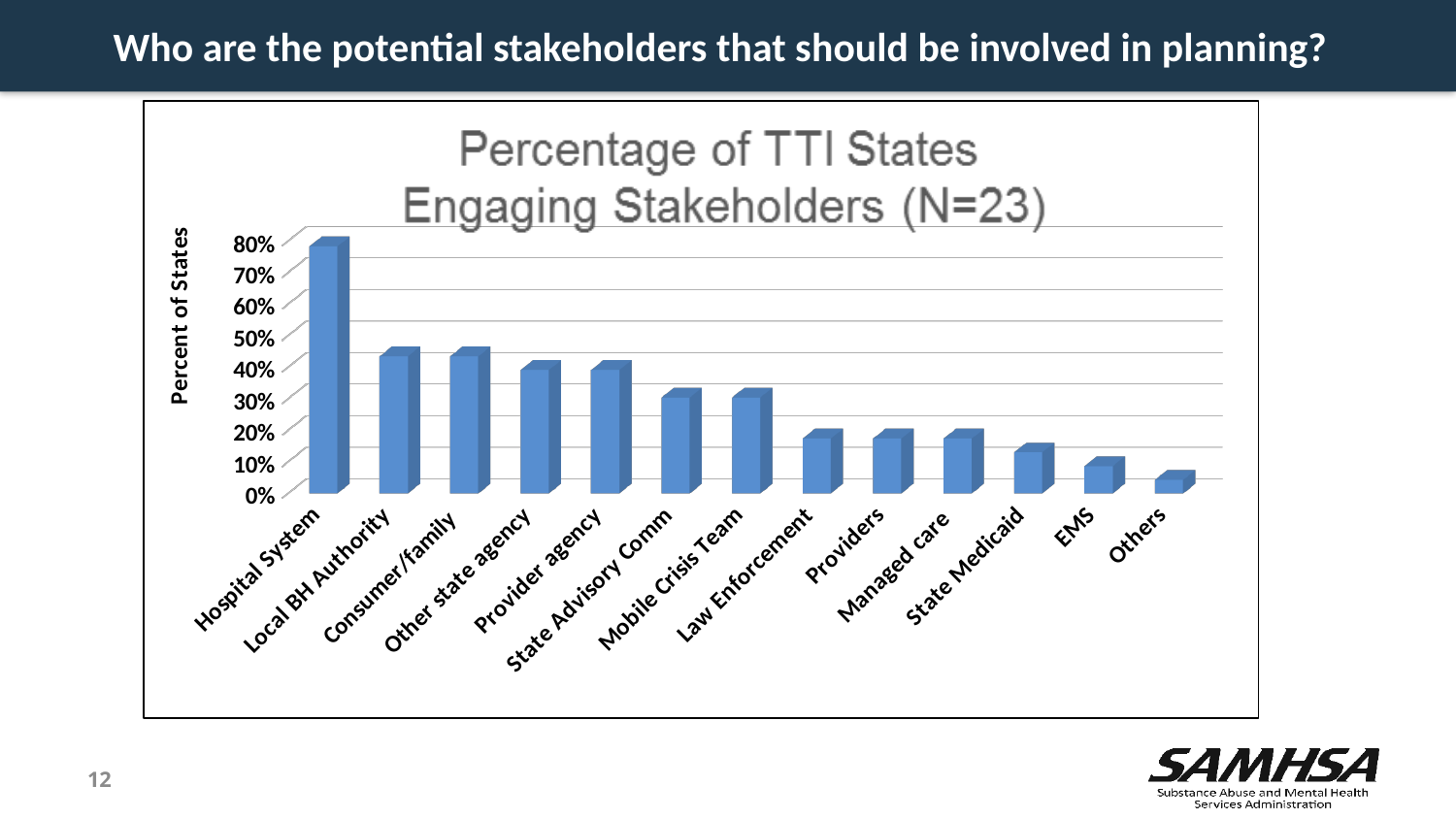
Which is larger, the value for Hospital System or the value for Consumer/family? Hospital System Is the value for Local BH Authority greater or less than 50%? less Which stakeholder category has the lowest percentage of states? Others Is the value for Mobile Crisis Team greater or less than 20%? greater Which stakeholder category has the highest percentage of states? Hospital System What is the title of the chart? Percentage of TTI States Engaging Stakeholders (N=23) How many stakeholder categories are shown on the x axis? 13 Is the value for Hospital System greater or less than 70%? greater What kind of chart is shown on the slide? bar chart Do the values generally rise or fall moving from left to right along the x axis? fall